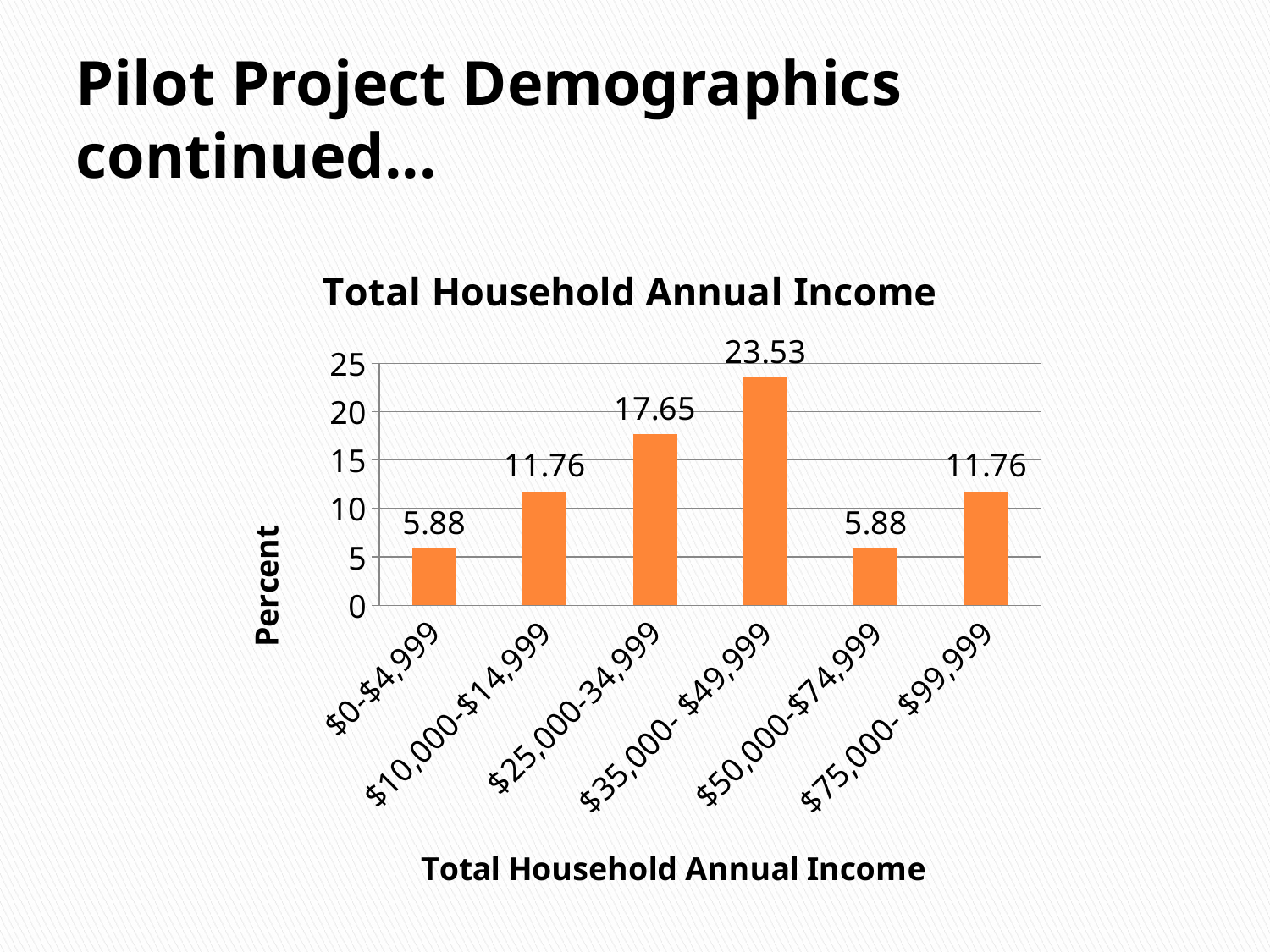
What is the value for $0-$4,999? 5.88 What is the difference between the values for $75,000- $99,999 and $50,000-$74,999? 5.88 What is the value for $25,000-34,999? 17.65 What is the value for $10,000-$14,999? 11.76 What is the difference between the values for $35,000- $49,999 and $25,000-34,999? 5.88 Is the value for $35,000- $49,999 greater or less than 20? greater What is the title of the chart? Total Household Annual Income What kind of chart is shown on the slide? bar chart Which income category has the highest value? $35,000- $49,999 Which is larger, the value for $25,000-34,999 or the value for $75,000- $99,999? $25,000-34,999 What is the value for $35,000- $49,999? 23.53 How many income categories are shown in the chart? 6